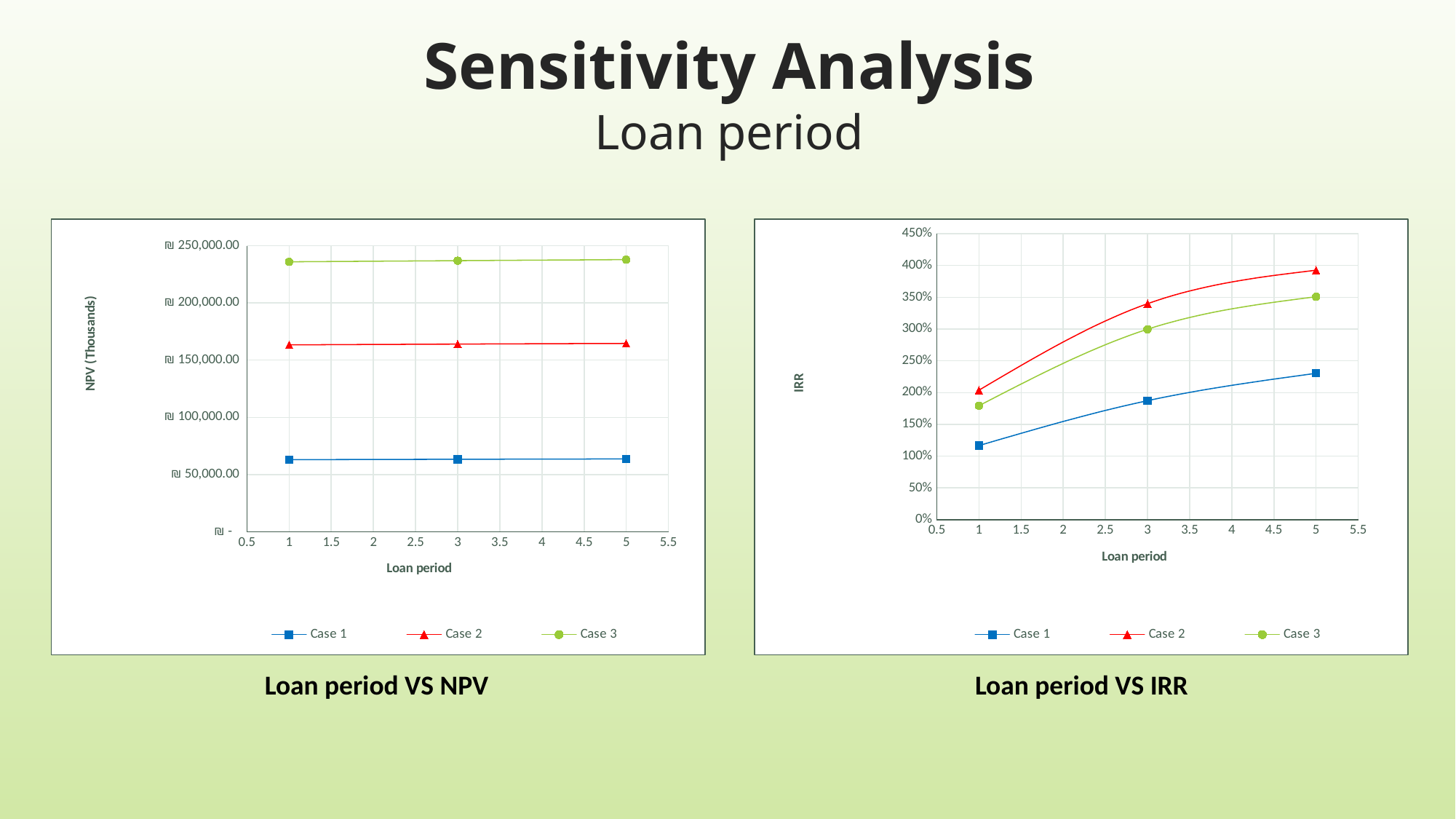
In the 'Loan period VS NPV' chart, is the value for Case 1 at loan period 5 greater or less than ₪ 100,000.00? less How many series does the legend of the 'Loan period VS IRR' chart list? 3 In the 'Loan period VS IRR' chart, do the IRR values rise or fall as the loan period increases? rise In the 'Loan period VS NPV' chart, is the value for Case 3 at loan period 1 greater or less than ₪ 200,000.00? greater In the 'Loan period VS IRR' chart, which series has the higher value at loan period 5, Case 2 or Case 3? Case 2 In the 'Loan period VS NPV' chart, which series has the highest NPV values? Case 3 What kind of chart is the 'Loan period VS NPV' chart? line chart In the 'Loan period VS IRR' chart, is the value for Case 3 at loan period 5 greater or less than 300%? greater What is the y-axis title of the 'Loan period VS NPV' chart? NPV (Thousands) In the 'Loan period VS IRR' chart, how many data points are plotted for Case 1? 3